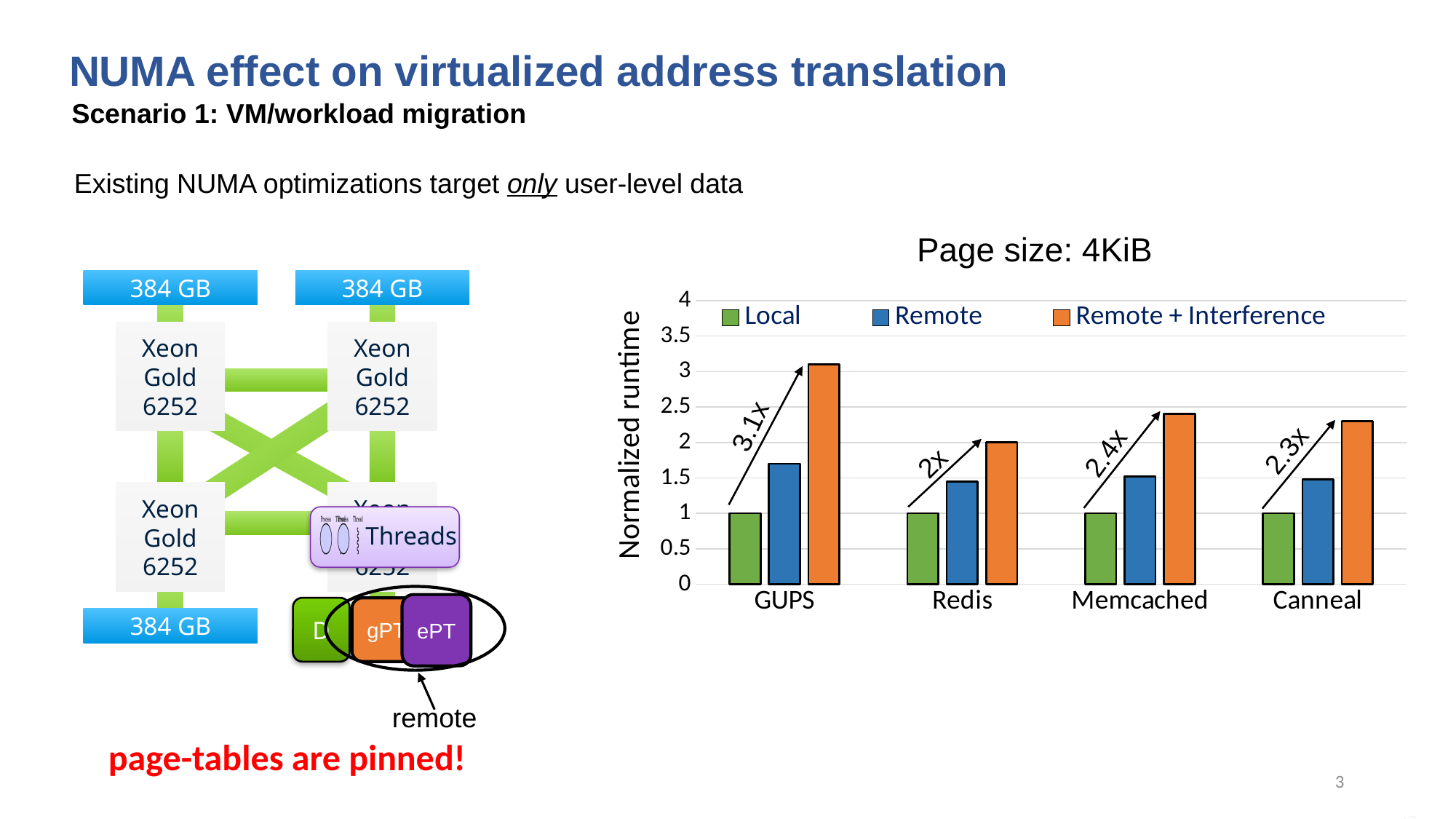
Is the Remote normalized runtime for GUPS greater or less than 1.5? greater Which is larger, the Remote normalized runtime for GUPS or for Redis? GUPS What kind of chart is shown on the slide? bar chart How many workload categories are shown on the x axis of the chart? 4 What is the title shown above the chart? Page size: 4KiB What is the Local normalized runtime for Redis? 1 What slowdown factor is annotated above the Memcached bars? 2.4x Which workload has the lowest Remote + Interference normalized runtime? Redis What slowdown factor is annotated above the GUPS bars? 3.1x How many series does the chart legend list? 3 Which workload has the highest Remote + Interference normalized runtime? GUPS What is the label of the chart's y axis? Normalized runtime